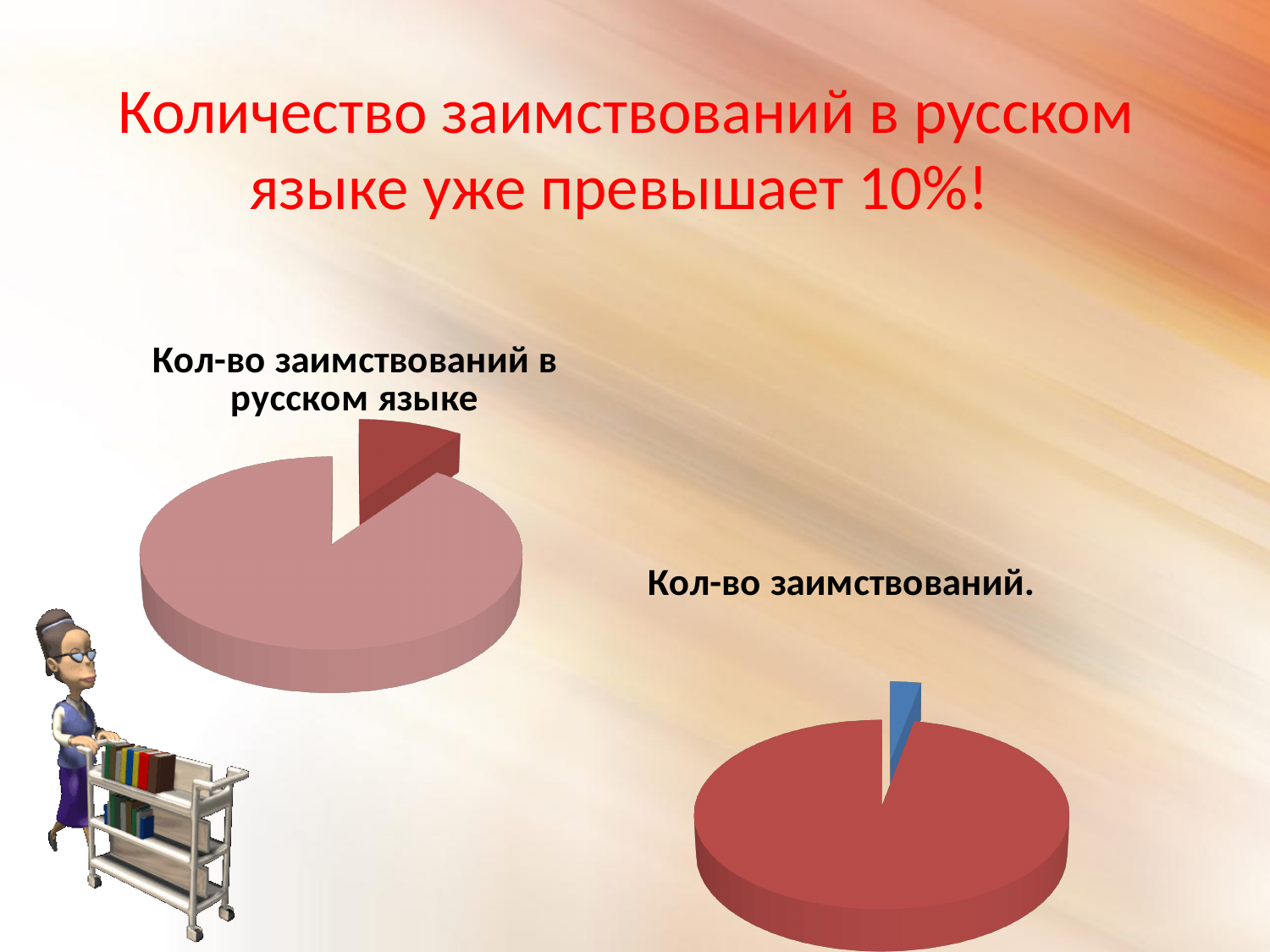
How many pie charts are shown on the slide? 2 In the pie chart titled "Кол-во заимствований в русском языке", which slice is the smallest? the dark red slice How many slices does the pie chart titled "Кол-во заимствований в русском языке" have? 2 What is the title of the pie chart on the right of the slide? Кол-во заимствований. What kind of chart is the chart titled "Кол-во заимствований в русском языке"? pie chart In the pie chart titled "Кол-во заимствований в русском языке", which slice is larger, the light pink one or the dark red one? the light pink one What kind of chart is the chart titled "Кол-во заимствований."? pie chart In the pie chart titled "Кол-во заимствований.", which slice is larger, the red one or the blue one? the red one What is the title of the pie chart on the left of the slide? Кол-во заимствований в русском языке How many slices does the pie chart titled "Кол-во заимствований." have? 2 In the pie chart titled "Кол-во заимствований.", which slice is the smallest? the blue slice